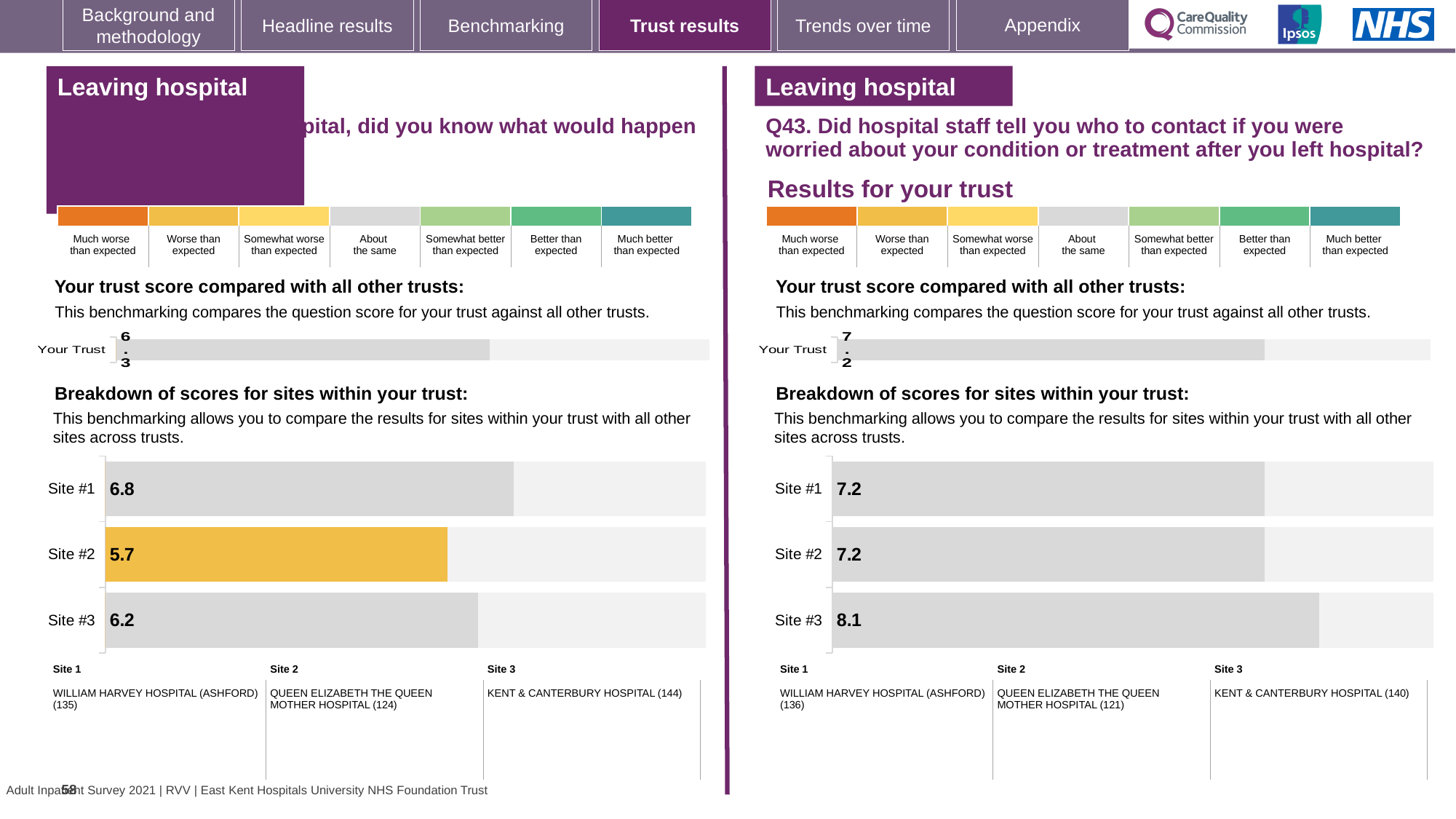
On the left half of the slide, in the site breakdown chart, what is the difference between the scores for Site #1 and Site #2? 1.1 On the right half of the slide (Q43), in the site breakdown chart, what is the difference between the scores for Site #3 and Site #1? 0.9 On the right half of the slide (Q43), what is the 'Your Trust' score shown in the 'Your trust score compared with all other trusts' chart? 7.2 What type of chart is used for the site breakdown on the right half of the slide (Q43)? bar chart On the left half of the slide, in the site breakdown chart, is the score for Site #3 larger or smaller than the score for Site #1? smaller On the left half of the slide, in the site breakdown chart, which site has the lowest score? Site #2 On the right half of the slide (Q43), in the site breakdown chart, what is the score for Site #3? 8.1 On the right half of the slide (Q43), how many sites are shown in the site breakdown chart? 3 On the left half of the slide, what is the 'Your Trust' score shown in the 'Your trust score compared with all other trusts' chart? 6.3 On the left half of the slide, in the site breakdown chart, which site has the highest score? Site #1 On the right half of the slide (Q43), in the site breakdown chart, which site has the highest score? Site #3 On the left half of the slide, in the 'Breakdown of scores for sites within your trust' chart, what is the score for Site #2? 5.7